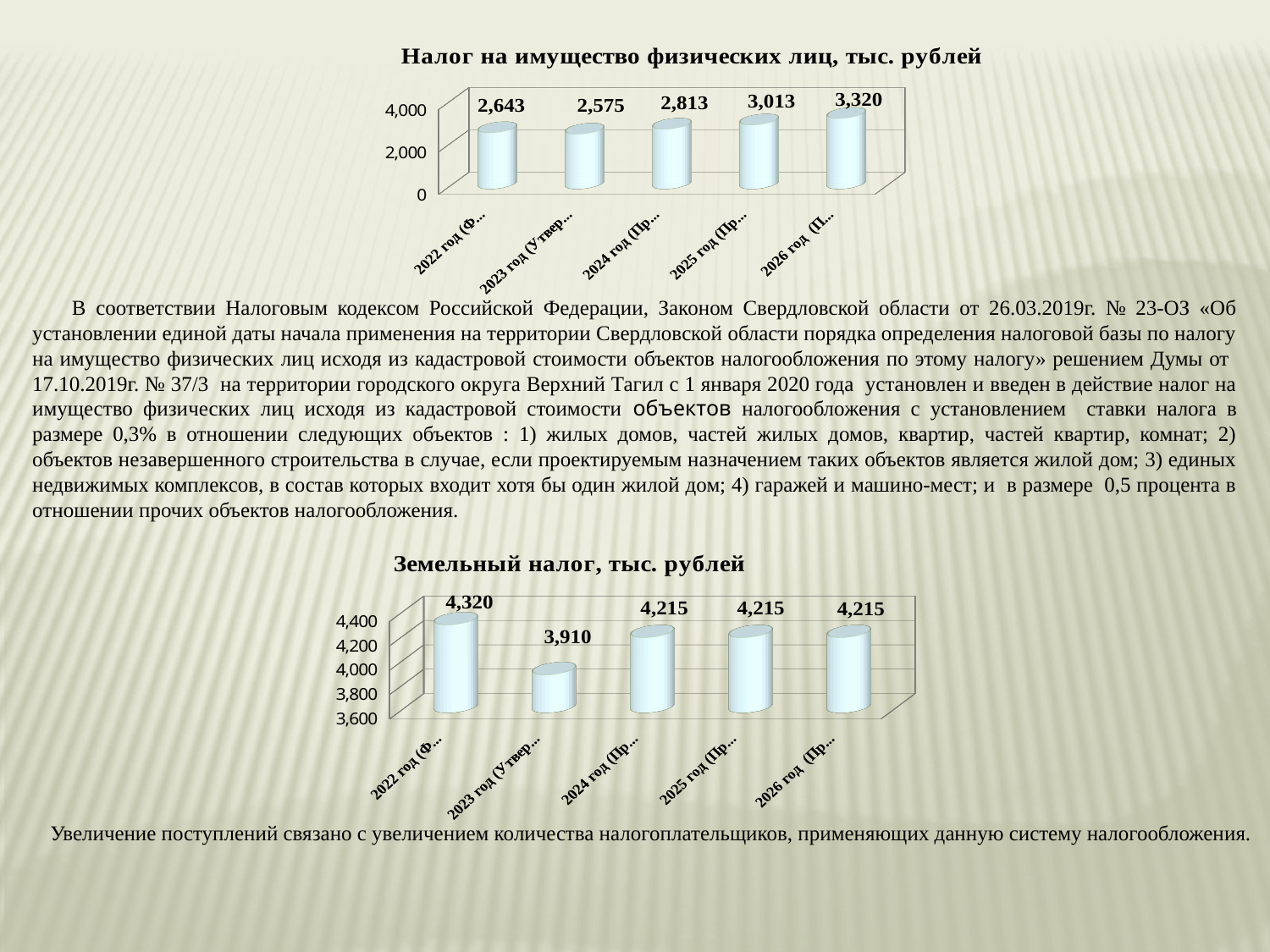
In the chart titled 'Земельный налог, тыс. рублей', what is the value for 2022 год? 4,320 In the chart titled 'Налог на имущество физических лиц, тыс. рублей', which year has the highest value? 2026 год In the chart titled 'Налог на имущество физических лиц, тыс. рублей', how many bars are plotted? 5 In the chart titled 'Налог на имущество физических лиц, тыс. рублей', what is the difference between the values for 2026 год and 2025 год? 307 In the chart titled 'Земельный налог, тыс. рублей', is the value for 2024 год larger or smaller than the value for 2023 год? larger In the chart titled 'Земельный налог, тыс. рублей', what is the value for 2023 год? 3,910 In the chart titled 'Земельный налог, тыс. рублей', what is the difference between the values for 2022 год and 2023 год? 410 In the chart titled 'Налог на имущество физических лиц, тыс. рублей', which year has the lowest value? 2023 год In the chart titled 'Налог на имущество физических лиц, тыс. рублей', what is the value for 2026 год? 3,320 In the chart titled 'Налог на имущество физических лиц, тыс. рублей', what is the value for 2022 год? 2,643 In the chart titled 'Земельный налог, тыс. рублей', which year has the highest value? 2022 год What kind of chart is the chart titled 'Земельный налог, тыс. рублей'? bar chart